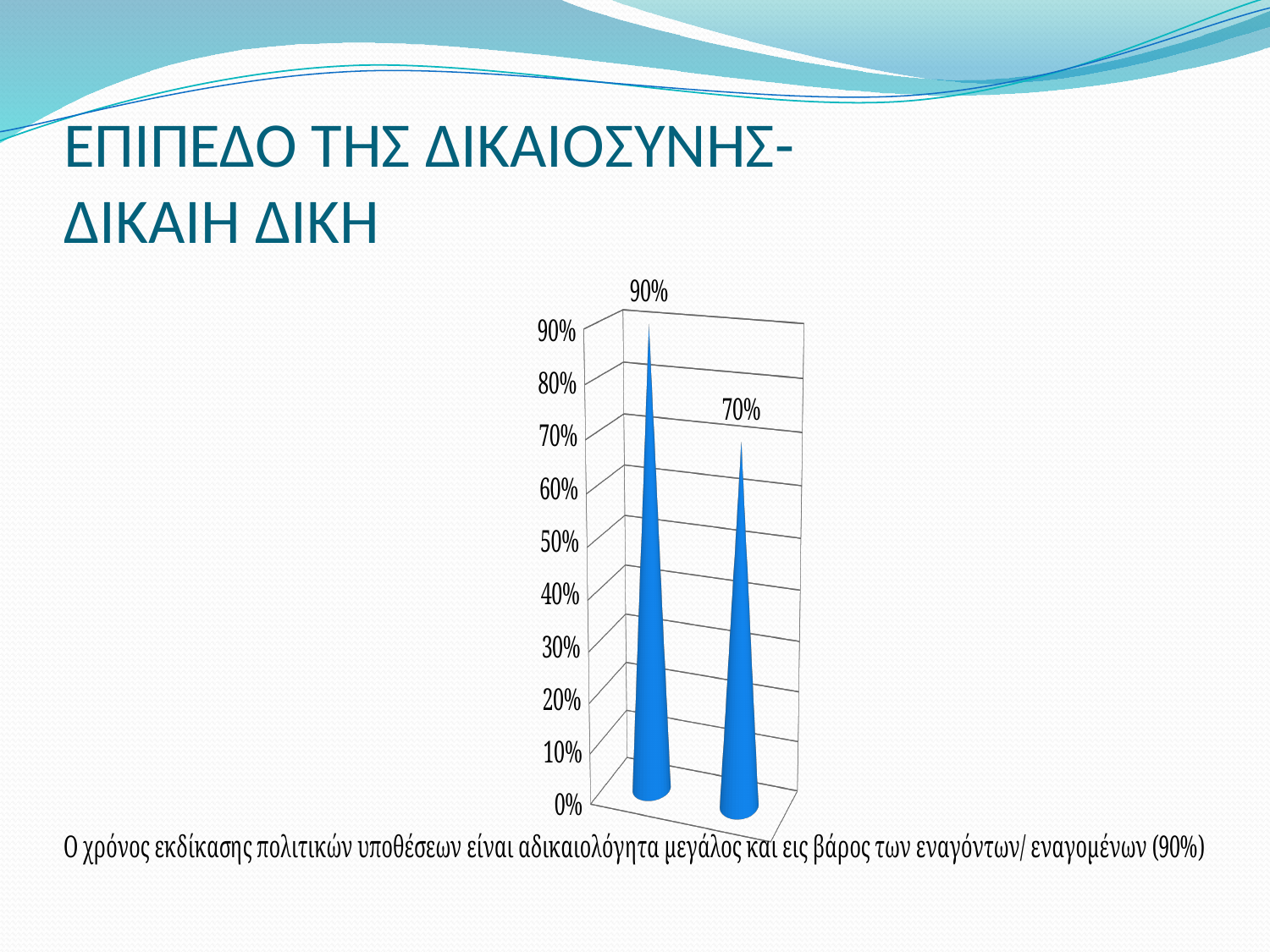
What value is shown by the data label on the right bar of the chart? 70% How many bars are plotted in the chart? 2 Is the value of the right bar greater or less than 80%? less What is the difference between the values of the left bar and the right bar? 20% Which bar has the highest value, the left or the right one? the left bar Which bar has the lowest value, the left or the right one? the right bar What value is shown by the data label on the left bar of the chart? 90% What colour are the bars in the chart? blue Is the value of the left bar larger or smaller than the value of the right bar? larger Do the values rise or fall from the left bar to the right bar? fall What is the highest tick value shown on the vertical axis of the chart? 90% What kind of chart is shown on the slide? bar chart